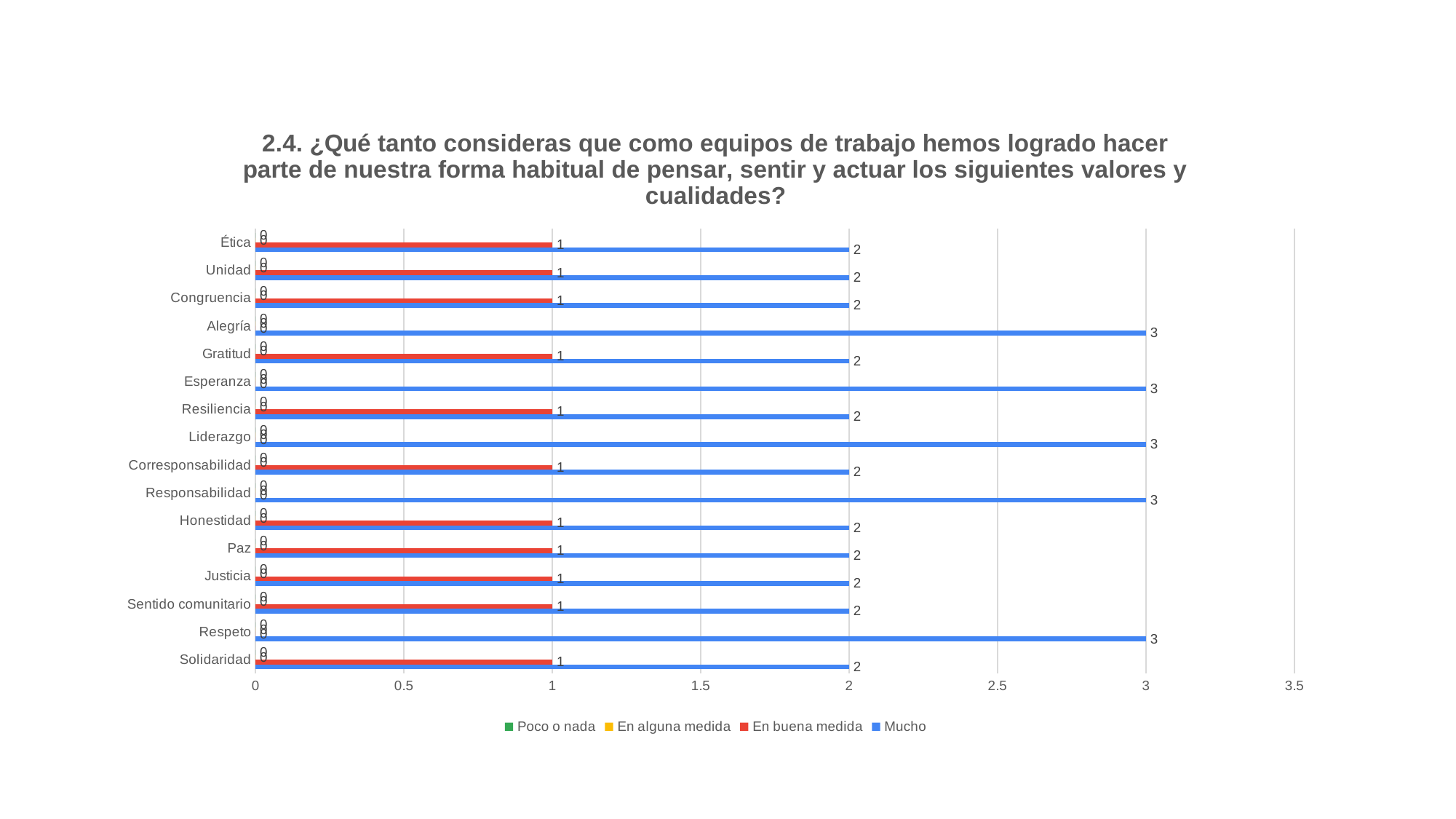
How many series does the legend list? 4 What is the difference between the "Mucho" values for Liderazgo and Honestidad? 1 What is the value of "En buena medida" for Responsabilidad? 0 What is the value of "Mucho" for Alegría? 3 What is the value of "Mucho" for Solidaridad? 2 What is the value of "Poco o nada" for Respeto? 0 What kind of chart is shown on the slide? bar chart What is the value of "En buena medida" for Ética? 1 Which series is shown in blue in the legend? Mucho How many categories are plotted on the chart? 16 Which is larger, the "Mucho" value for Esperanza or the "Mucho" value for Gratitud? Esperanza